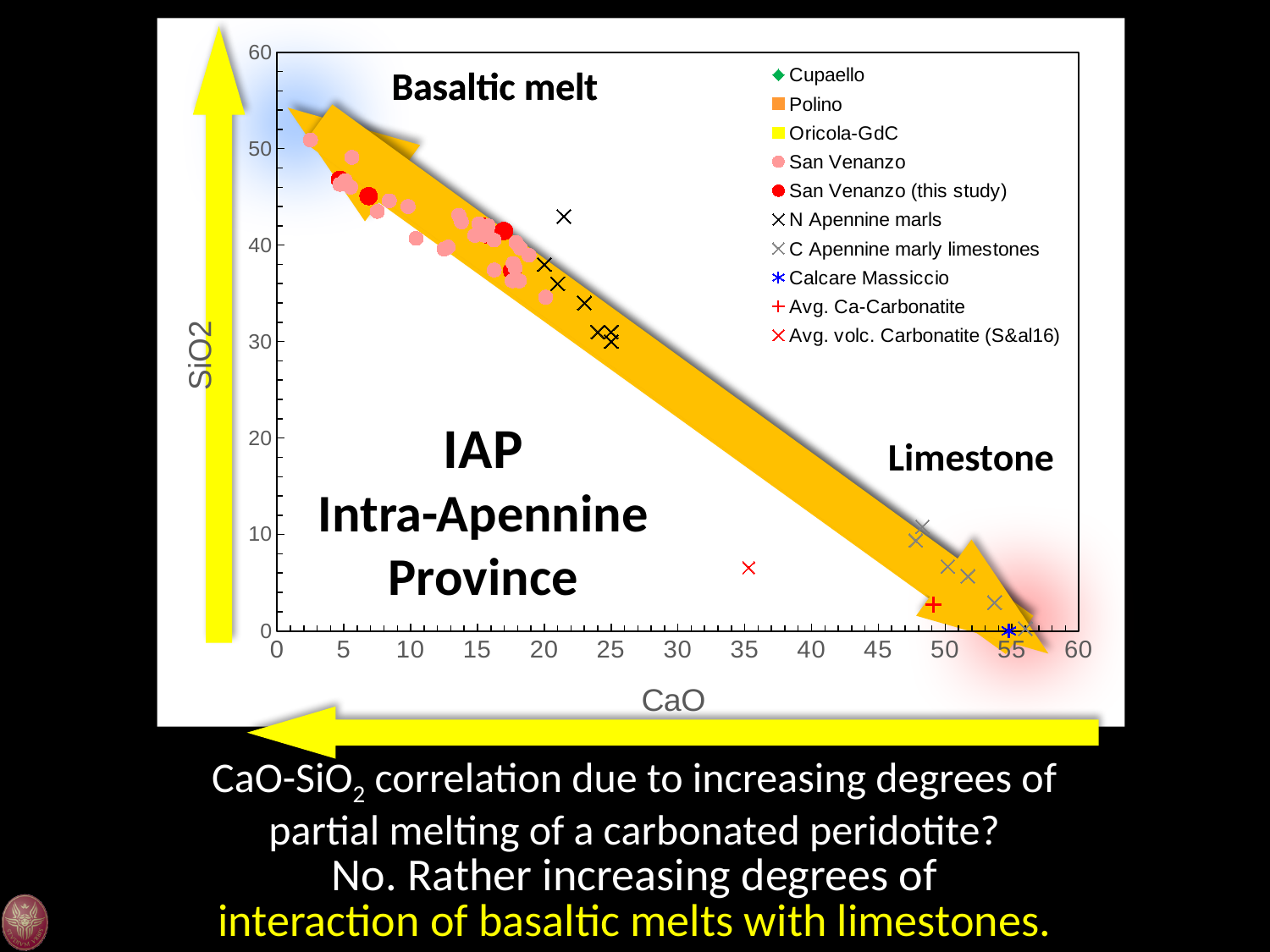
Is the CaO value for Avg. volc. Carbonatite (S&al16) greater or less than 30? greater As CaO increases along the x axis, do the SiO2 values of the plotted samples rise or fall? fall Is the SiO2 value for Avg. Ca-Carbonatite greater or less than 5? less What is the label of the y axis? SiO2 Is the SiO2 value for Avg. volc. Carbonatite (S&al16) greater or less than 10? less What kind of chart is shown on the slide? scatter plot What is the label of the x axis? CaO How many series does the legend list? 10 Which has the higher SiO2 value, Avg. volc. Carbonatite (S&al16) or Avg. Ca-Carbonatite? Avg. volc. Carbonatite (S&al16) Which has the higher CaO value, Avg. Ca-Carbonatite or Avg. volc. Carbonatite (S&al16)? Avg. Ca-Carbonatite